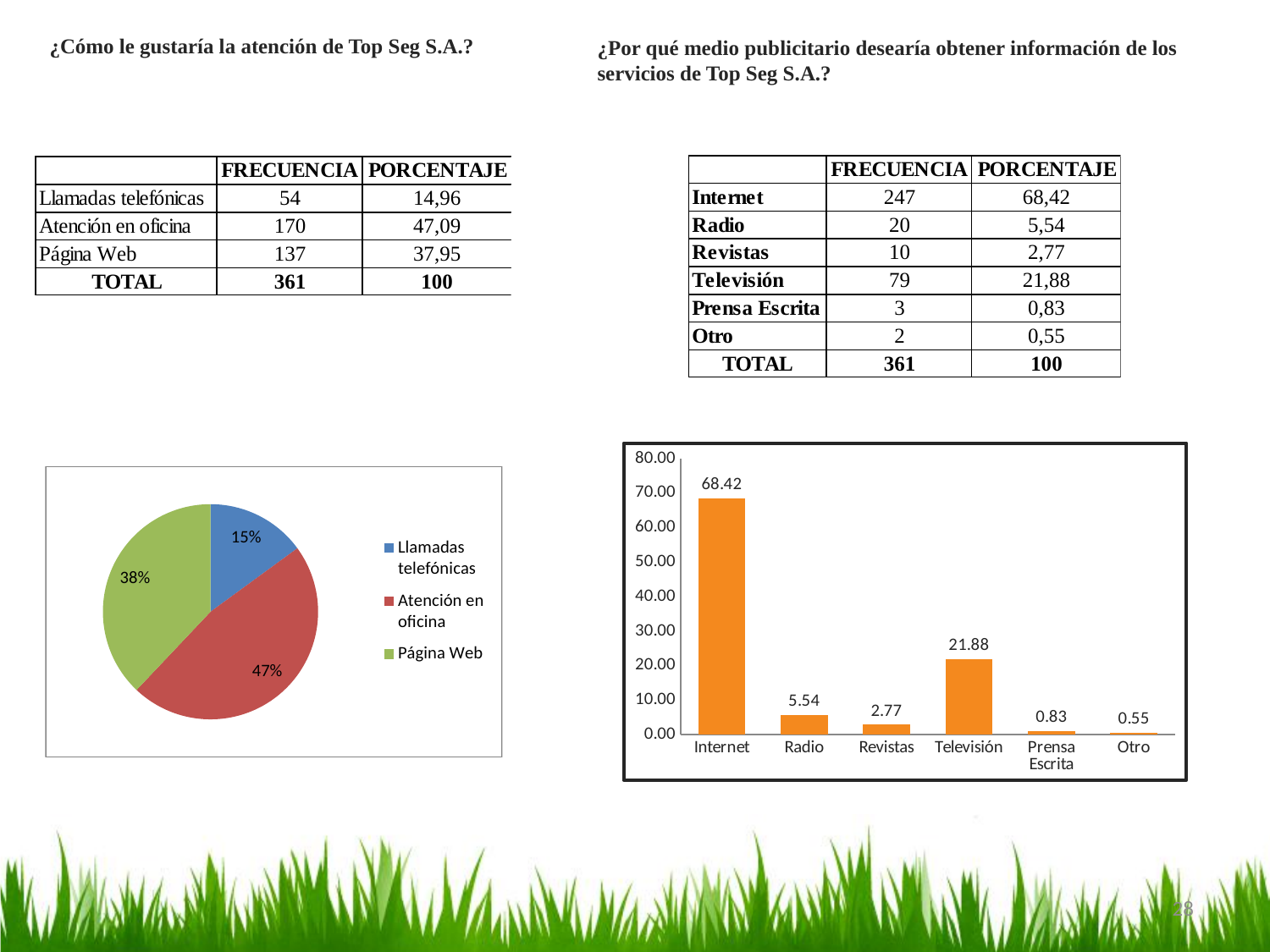
In the pie chart on the left, which category has the largest slice? Atención en oficina In the bar chart on the right, what is the value for Televisión? 21.88 In the bar chart on the right, which category has the highest value? Internet In the pie chart on the left, what share does Atención en oficina have? 47% How many categories are shown on the x axis of the bar chart on the right? 6 In the bar chart on the right, what is the difference between the values for Internet and Televisión? 46.54 In the bar chart on the right, which category has the lowest value? Otro In the pie chart on the left, which category has the smallest slice? Llamadas telefónicas In the bar chart on the right, what is the value for Radio? 5.54 In the pie chart on the left, what share does Página Web have? 38% How many slices does the pie chart on the left have? 3 What type of chart is shown on the left of the slide? Pie chart